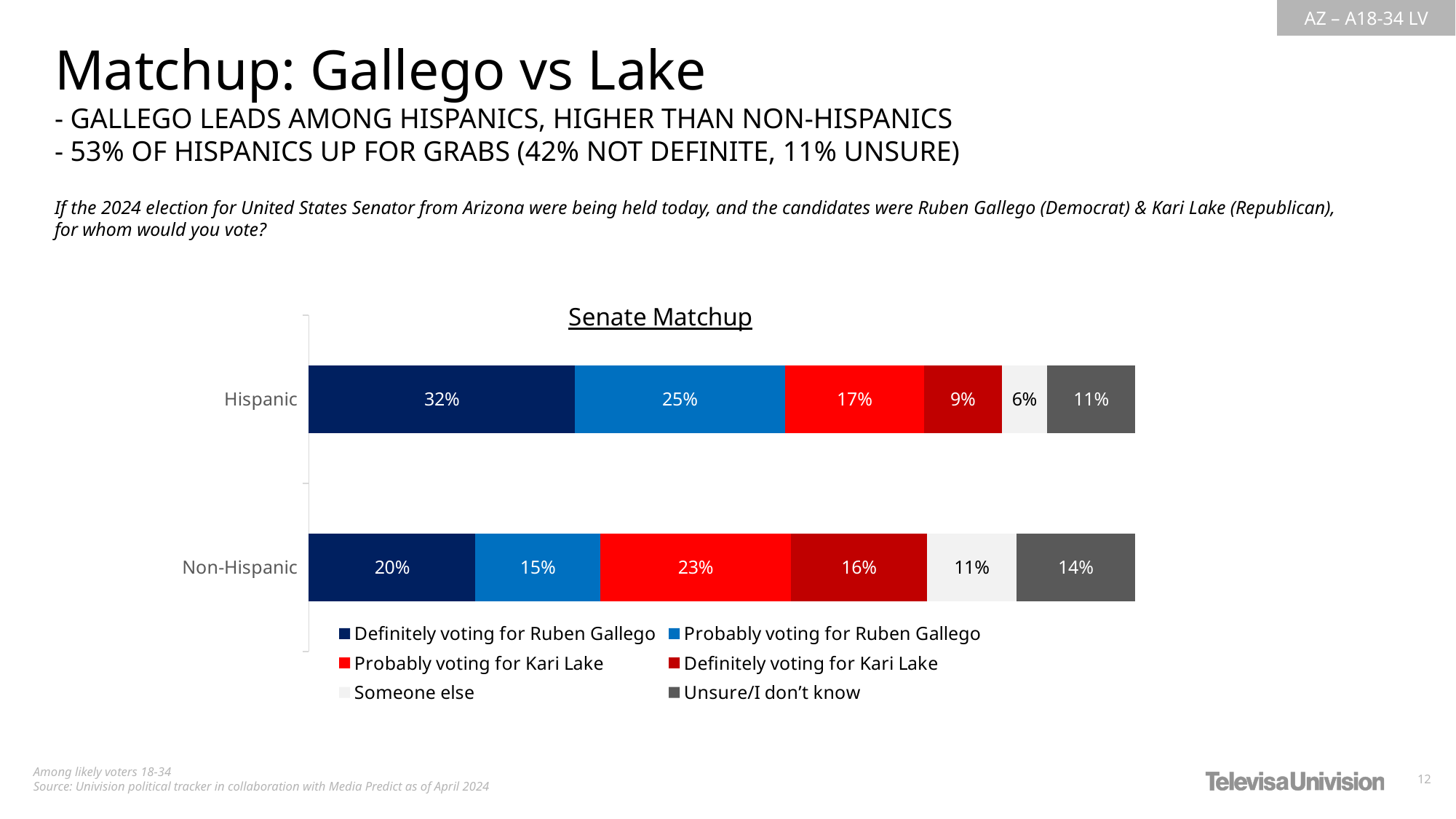
Which response category has the largest share among Hispanic respondents? Definitely voting for Ruben Gallego What is the difference between the Hispanic and Non-Hispanic shares definitely voting for Ruben Gallego? 12% What is the title of the chart? Senate Matchup What percentage of Non-Hispanic likely voters are probably voting for Kari Lake? 23% How many series does the legend list? 6 What is the combined share of Hispanic respondents definitely or probably voting for Ruben Gallego? 57% Which group has a larger share definitely voting for Kari Lake, Hispanic or Non-Hispanic? Non-Hispanic What percentage of Hispanic likely voters are definitely voting for Ruben Gallego? 32% What percentage of Non-Hispanic respondents chose Someone else? 11% What percentage of Hispanic respondents answered Unsure/I don't know? 11% Which response category has the smallest share among Hispanic respondents? Someone else What type of chart is shown on the slide? Stacked bar chart